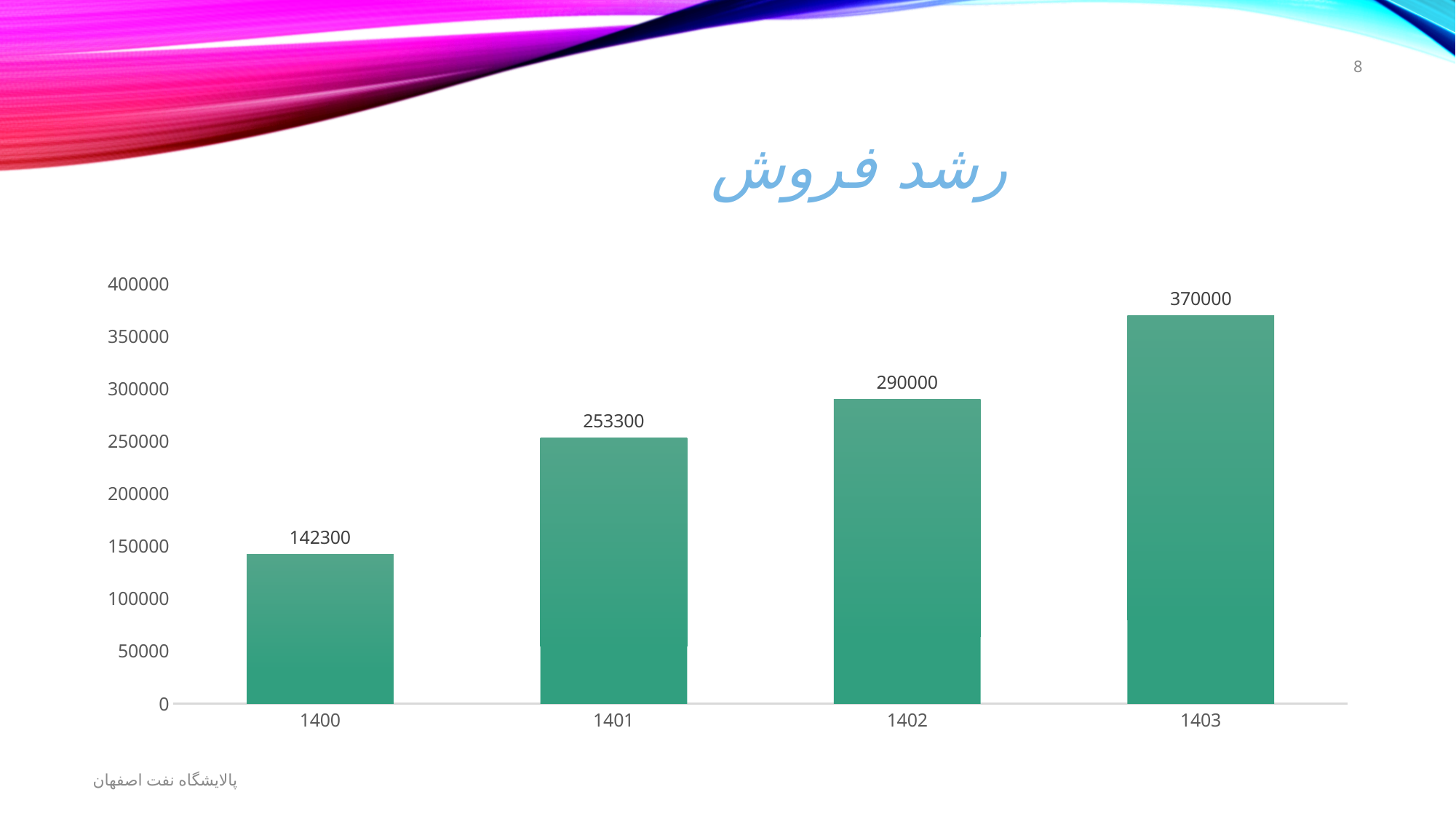
What is the difference between the values for 1401 and 1400? 111000 Which year has the highest value? 1403 Which is larger, the value for 1401 or the value for 1402? 1402 What kind of chart is shown on the slide? bar chart Do the values rise or fall from 1400 to 1403? rise How many years are shown on the x axis? 4 What is the value for 1402? 290000 What is the difference between the values for 1403 and 1402? 80000 What is the value for 1401? 253300 What is the value for 1403? 370000 Which year has the lowest value? 1400 What is the value for 1400? 142300